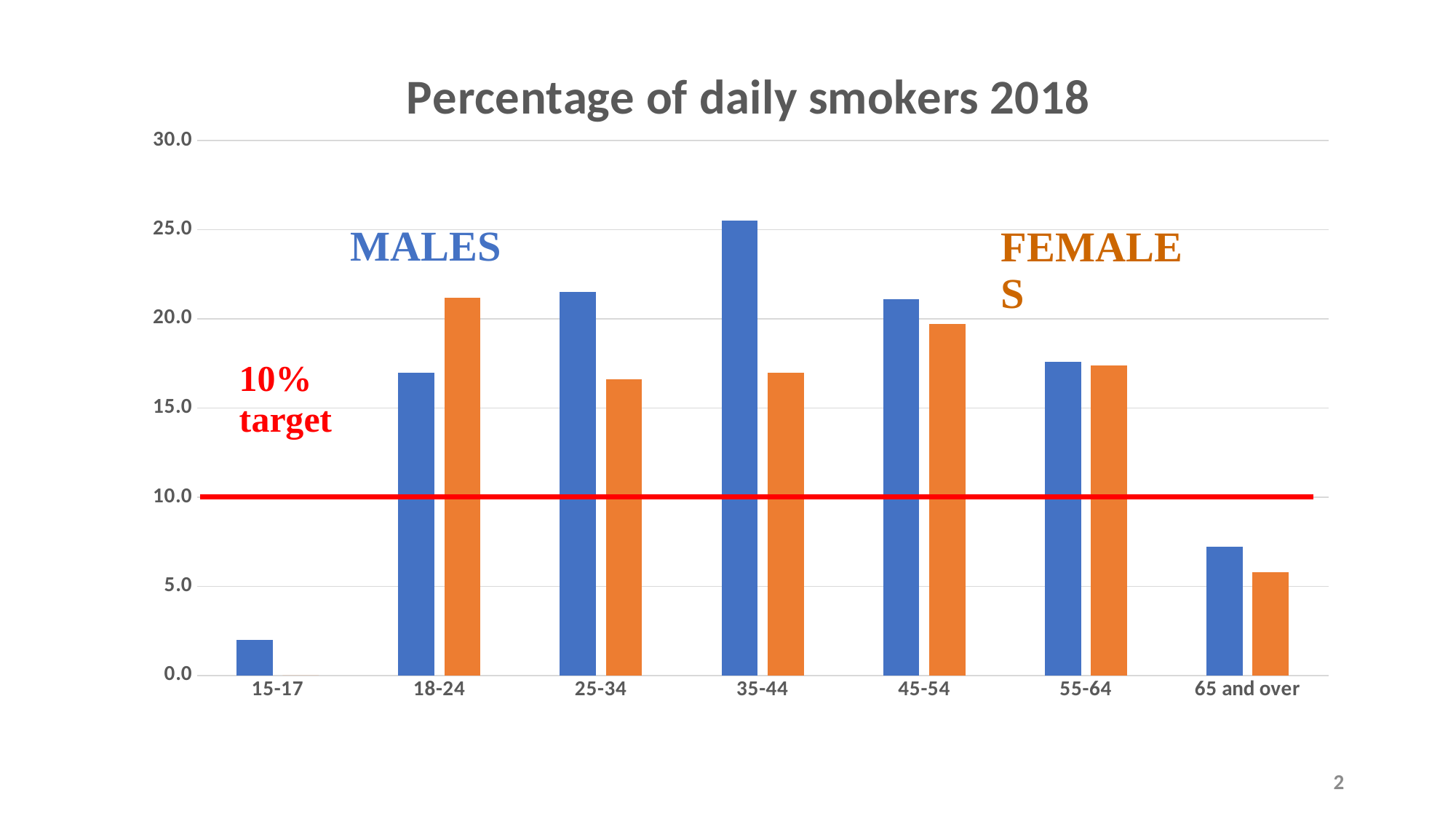
Which age group has the highest value for females? 18-24 What kind of chart is shown on the slide? Bar chart In the 35-44 age group, which is larger, the value for males or for females? Males Is the value for males aged 35-44 greater or less than 25.0? greater How many age groups are shown on the x axis? 7 Is the value for males aged 15-17 greater or less than 5.0? less Which age group has the lowest value for males? 15-17 In the 18-24 age group, which is larger, the value for males or for females? Females Which age group has the highest value for males? 35-44 What value does the red horizontal target line mark on the chart? 10% target How many series are plotted in the chart? 2 What is the title of the chart? Percentage of daily smokers 2018